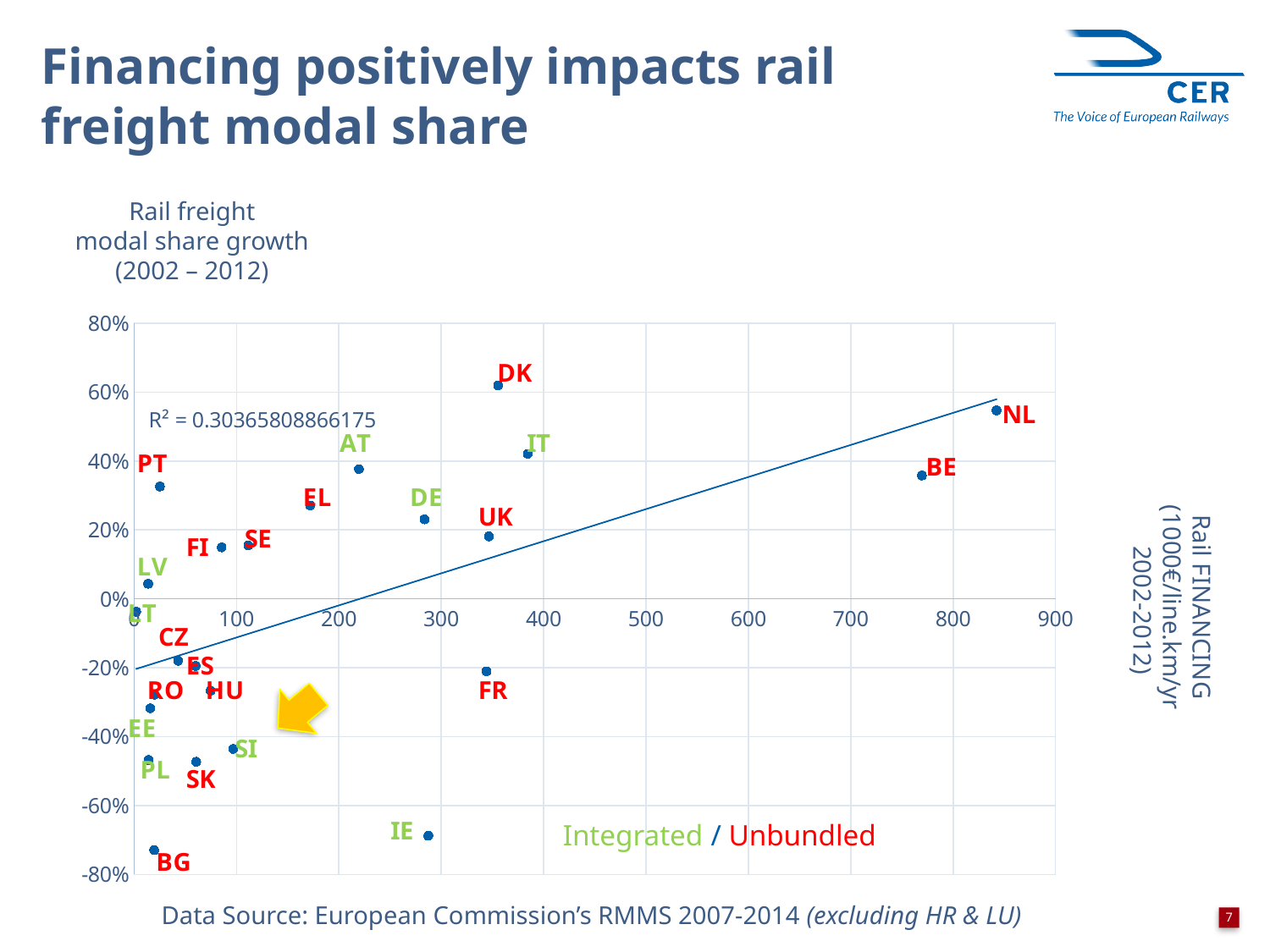
Is the rail financing value for NL greater or less than 800? greater What kind of chart is shown on the slide? scatter chart Which has the higher rail financing value, BE or NL? NL Which colour is used for the labels of integrated railways in the chart? green Is the rail freight modal share growth for BG greater or less than -60%? less Is the rail freight modal share growth for PT greater or less than 20%? greater Which country has the lowest rail freight modal share growth (2002 – 2012)? BG Does the fitted trend line rise or fall as rail financing increases? rise What R² value is printed on the chart? 0.30365808866175 Which has the higher rail freight modal share growth, DK or NL? DK Which country has the highest rail freight modal share growth (2002 – 2012)? DK Which country has the highest rail financing (1000€/line.km/yr)? NL